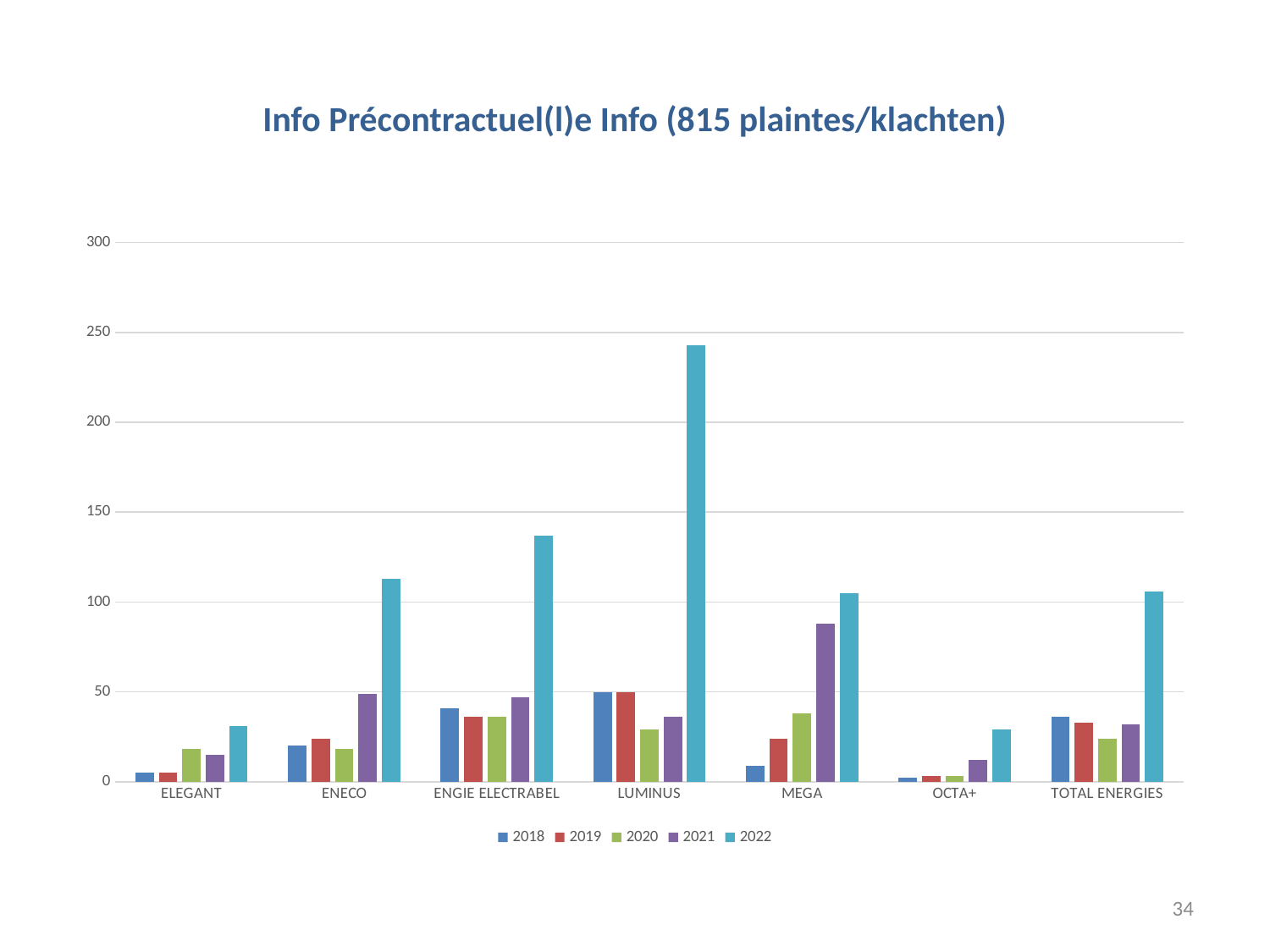
For MEGA, do the values rise or fall from 2018 to 2022? rise How many series does the legend list? 5 Which year has the highest bar for ELEGANT? 2022 How many supplier categories are shown on the x axis? 7 What kind of chart is shown on the slide? Bar chart Is the 2022 value for ENGIE ELECTRABEL greater or less than 150? less Is the 2022 value for ENECO greater or less than 100? greater Which is larger: the 2021 value for MEGA or the 2021 value for ENECO? MEGA Which supplier has the highest bar for 2022? LUMINUS Is the 2022 value for LUMINUS greater or less than 200? greater What is the title of the chart? Info Précontractuel(l)e Info (815 plaintes/klachten)